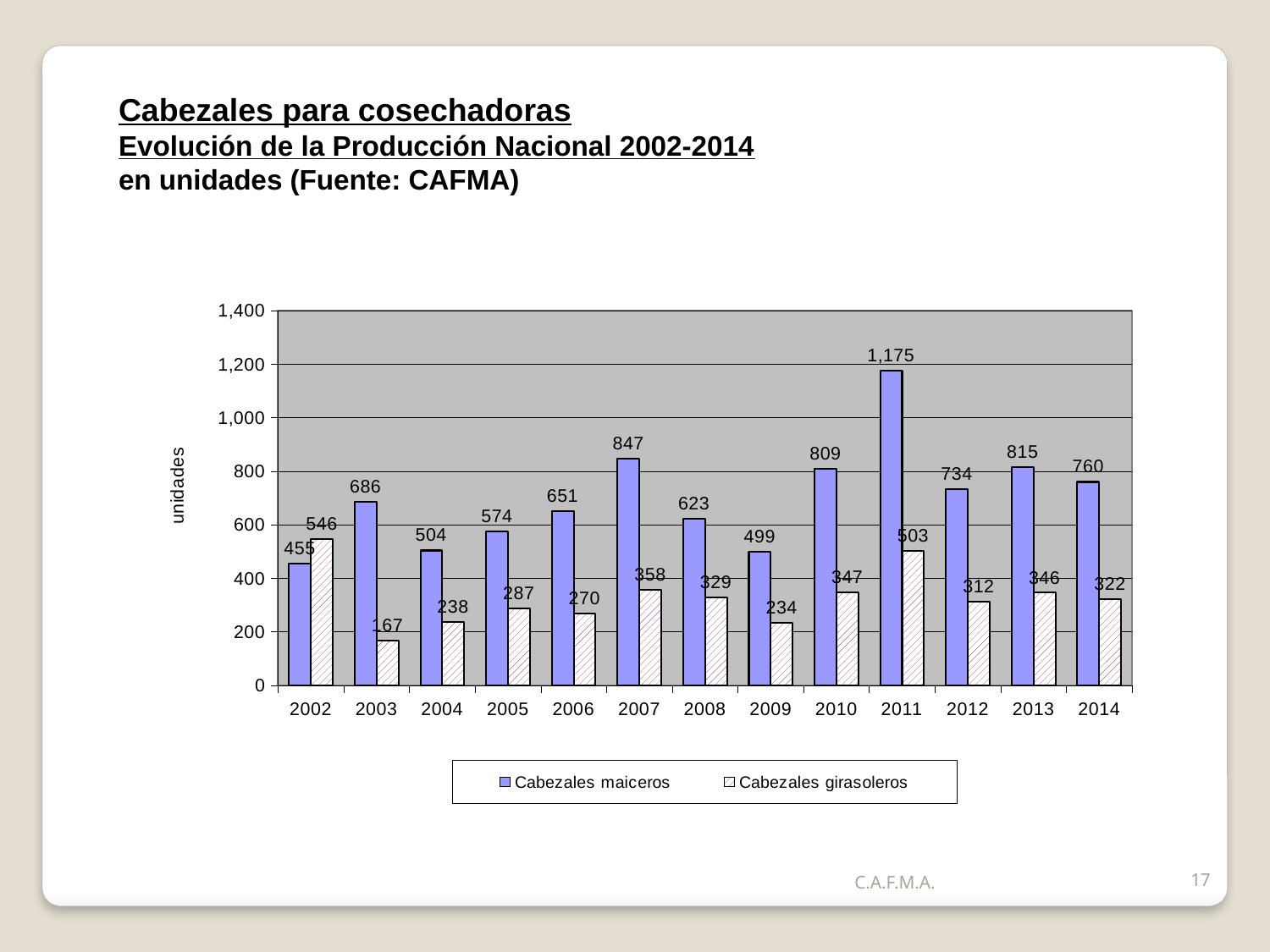
What is the label of the y axis? unidades Which year has the lowest value for Cabezales girasoleros? 2003 What is the difference between Cabezales maiceros and Cabezales girasoleros in 2014? 438 What is the value for Cabezales maiceros in 2009? 499 Which is larger in 2002, Cabezales maiceros or Cabezales girasoleros? Cabezales girasoleros Which year has the highest value for Cabezales maiceros? 2011 What kind of chart is shown on the slide? bar chart How many series does the legend list? 2 How many years are shown on the x axis? 13 What is the value for Cabezales girasoleros in 2003? 167 What is the value for Cabezales maiceros in 2011? 1,175 Is the value for Cabezales maiceros in 2007 greater or less than 800? greater